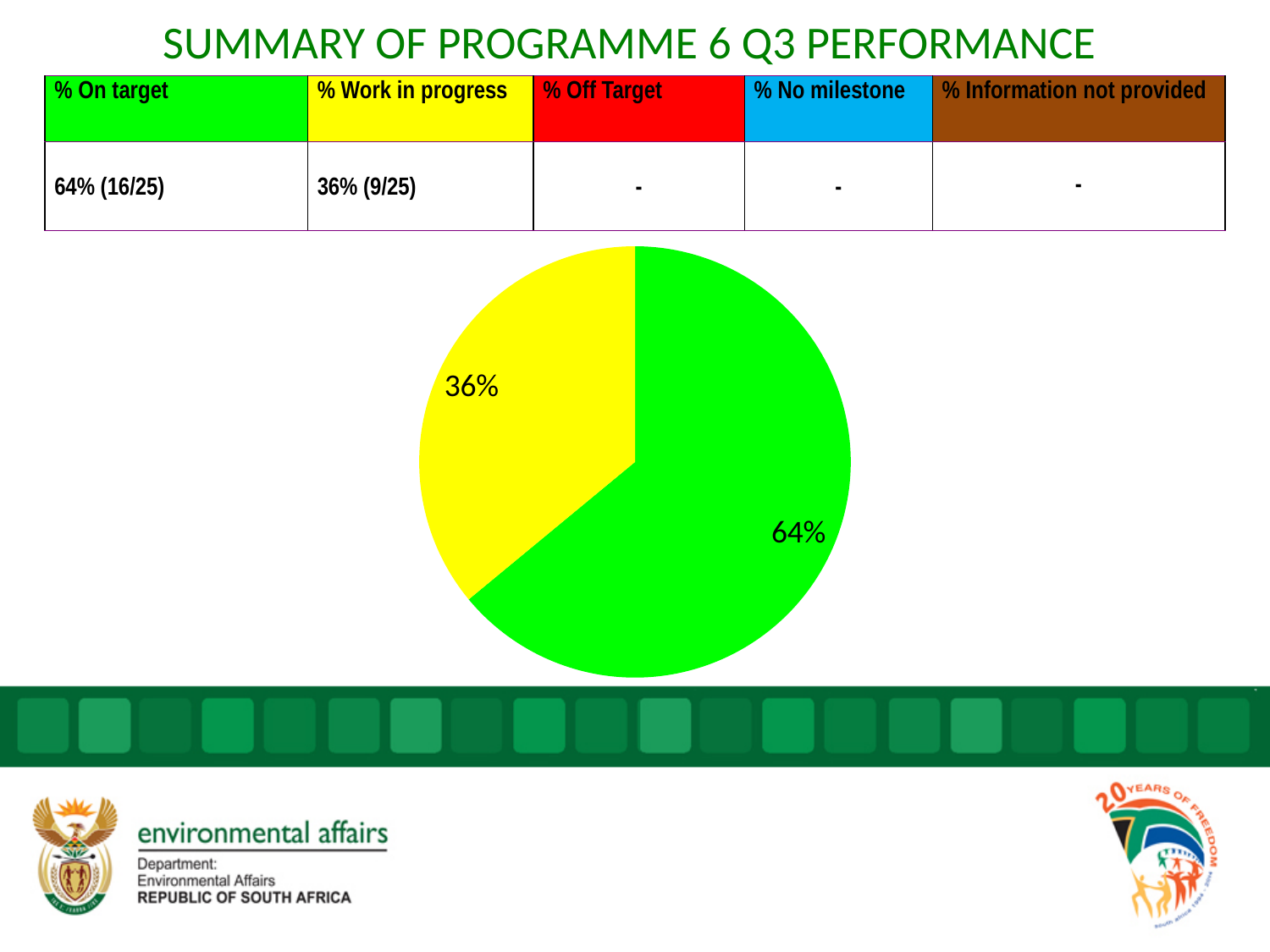
What is the title of the slide containing the pie chart? SUMMARY OF PROGRAMME 6 Q3 PERFORMANCE Which slice of the pie chart is the smallest? 36% What percentage is shown on the yellow slice of the pie chart? 36% What percentage is shown on the green slice of the pie chart? 64% What share of the pie does the yellow slice represent? 36% What is the difference between the two slices of the pie chart? 28% According to the table above the pie chart, which status does the green colour represent? % On target What kind of chart is shown on the slide? pie chart Is the value of the green slice in the pie chart greater or less than 50%? greater How many slices does the pie chart have? 2 Which slice of the pie chart is the largest? 64% Which is larger in the pie chart, the green slice or the yellow slice? green slice